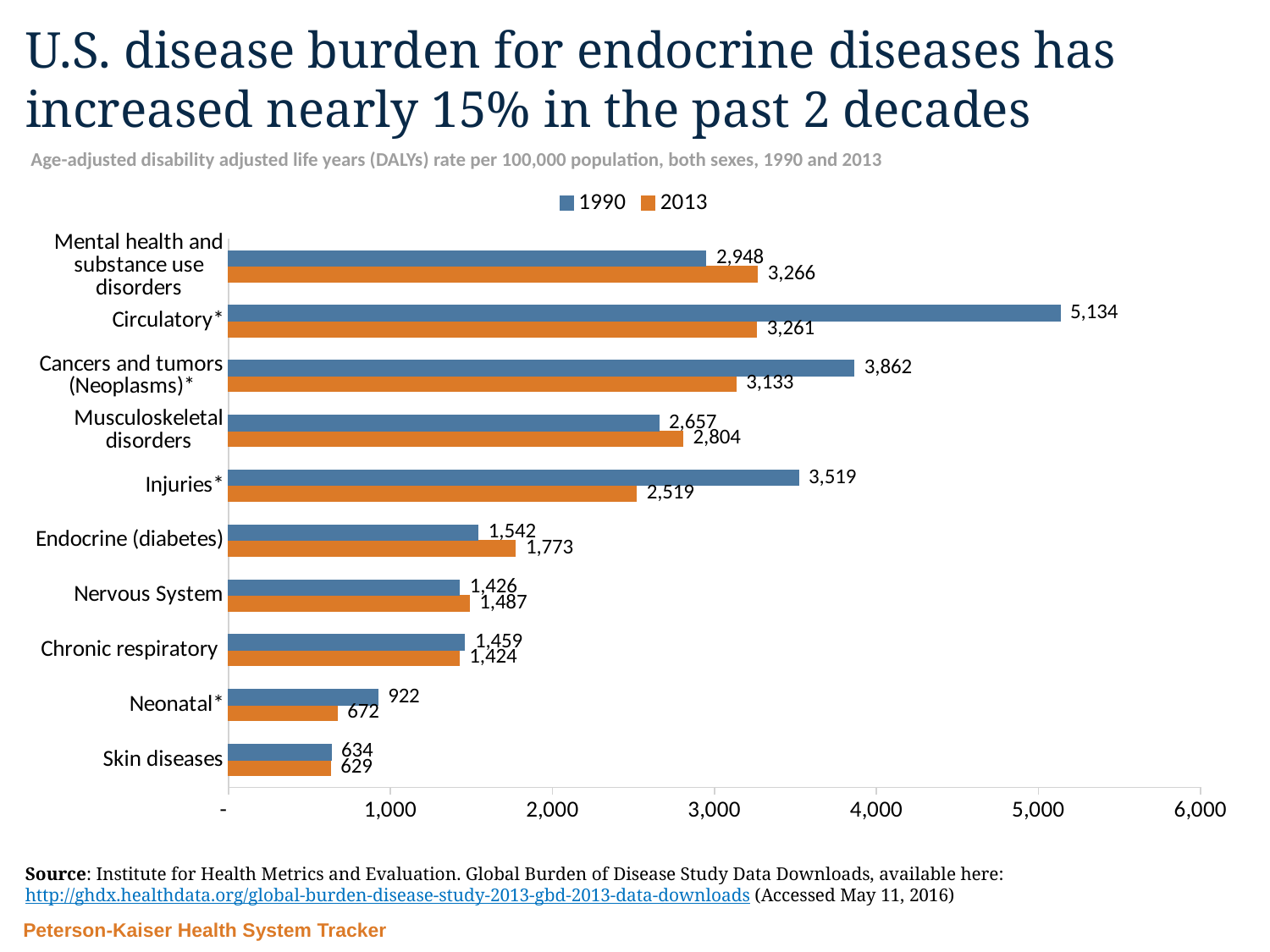
How many categories are shown on the chart? 10 Which category has the highest 1990 value? Circulatory* What is the difference between the 2013 and 1990 values for Endocrine (diabetes)? 231 What is the 1990 value for Circulatory*? 5,134 Is the 1990 value for Cancers and tumors (Neoplasms)* greater or less than 3,000? greater Which category has the lowest 2013 value? Skin diseases What is the difference between the 1990 and 2013 values for Injuries*? 1,000 What is the 2013 value for Endocrine (diabetes)? 1,773 What kind of chart is shown on the slide? Bar chart What is the 2013 value for Mental health and substance use disorders? 3,266 How many series does the legend list? 2 Which is larger for Neonatal*: the 1990 value or the 2013 value? 1990